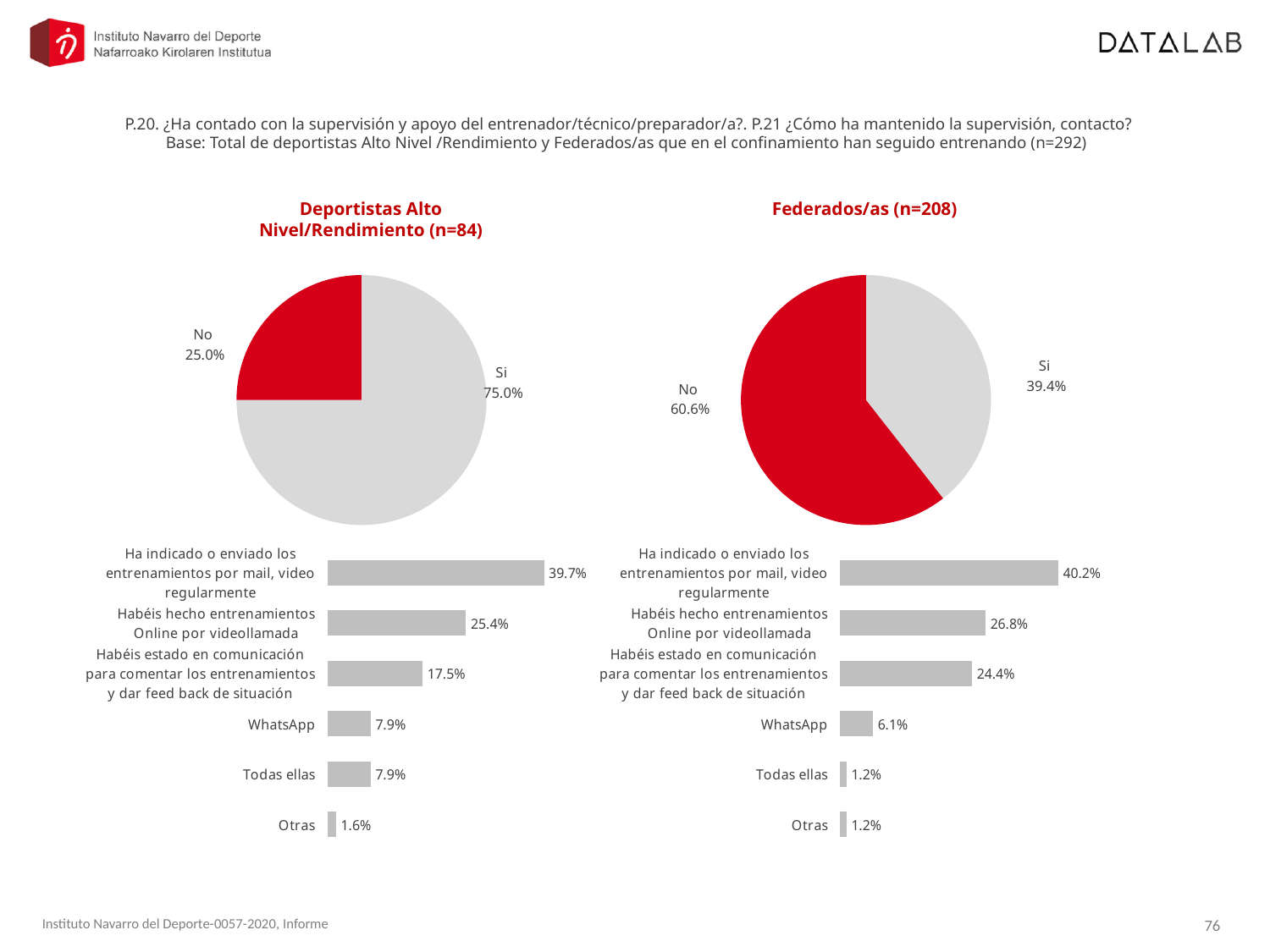
In the bar chart on the right (Federados/as), which category has the highest value? Ha indicado o enviado los entrenamientos por mail, video regularmente What colour is the 'No' slice in the 'Federados/as (n=208)' pie chart? Red In the bar chart on the left (Deportistas Alto Nivel/Rendimiento), what is the difference between 'Ha indicado o enviado los entrenamientos por mail, video regularmente' and 'Habéis hecho entrenamientos Online por videollamada'? 14.3% In the bar chart on the left (Deportistas Alto Nivel/Rendimiento), what is the value for 'Habéis hecho entrenamientos Online por videollamada'? 25.4% In the 'Federados/as (n=208)' pie chart, what share is 'No'? 60.6% How many categories are shown in the bar chart on the left (Deportistas Alto Nivel/Rendimiento)? 6 In the bar chart on the right (Federados/as), what is the value for 'WhatsApp'? 6.1% In the 'Deportistas Alto Nivel/Rendimiento (n=84)' pie chart, what share is 'Si'? 75.0% In the bar chart on the left (Deportistas Alto Nivel/Rendimiento), which category has the lowest value? Otras In the 'Federados/as (n=208)' pie chart, which slice is larger, 'Si' or 'No'? No What type of chart is used to show 'Si' and 'No' under the 'Deportistas Alto Nivel/Rendimiento (n=84)' title? Pie chart In the bar chart on the right (Federados/as), what is the difference between 'Habéis hecho entrenamientos Online por videollamada' and 'Habéis estado en comunicación para comentar los entrenamientos y dar feed back de situación'? 2.4%